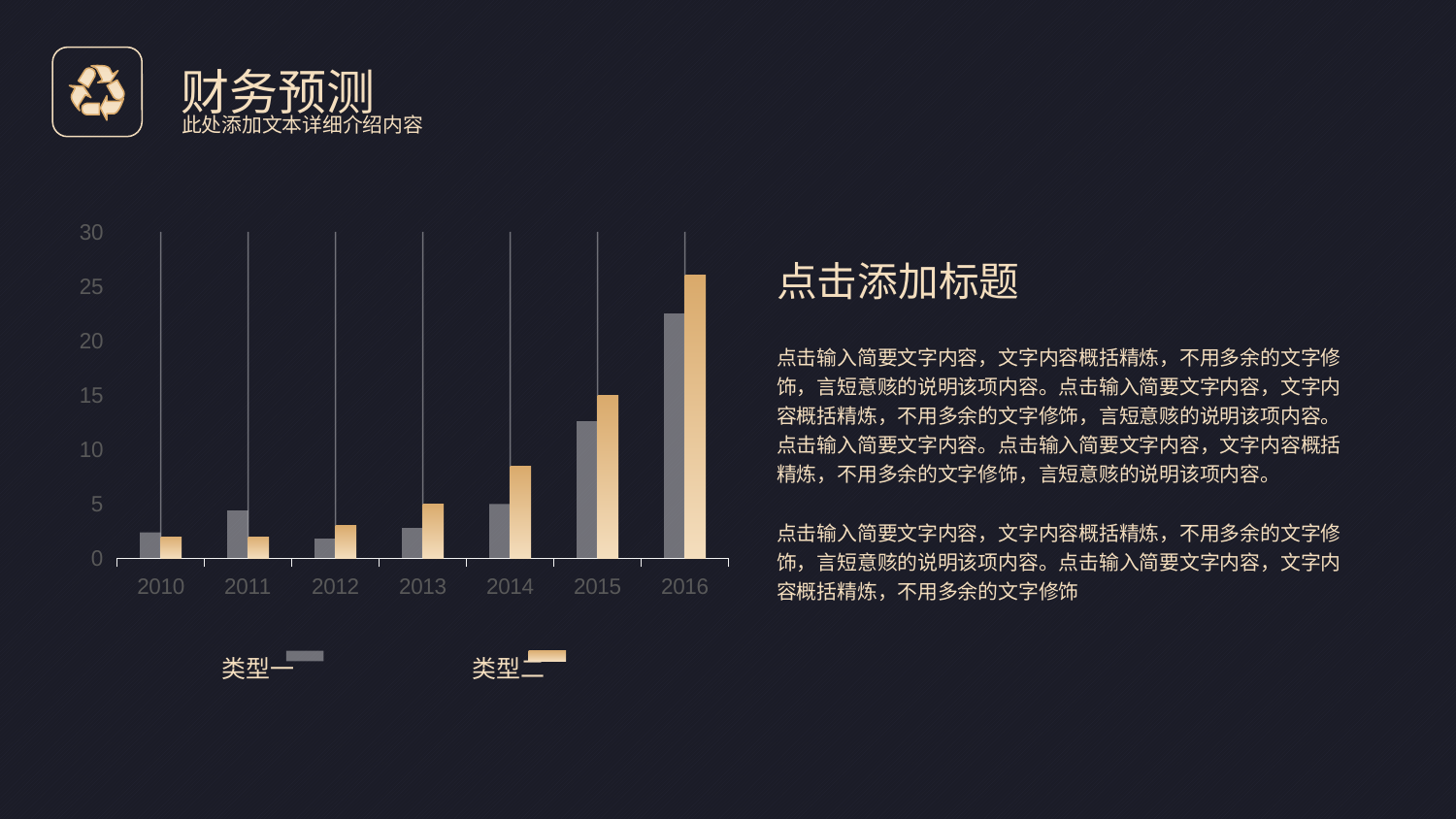
How many series does the chart legend list? 2 Is the value for 类型二 in 2015 greater or less than 10? greater Is the value for 类型二 in 2016 greater or less than 25? greater Do the values for 类型二 generally rise or fall from 2012 to 2016? rise Is the value for 类型一 in 2014 greater or less than 10? less In 2015, which series has the larger value, 类型一 or 类型二? 类型二 How many years are shown on the x axis of the chart? 7 What kind of chart is shown on the slide? bar chart Which year has the highest value for 类型一? 2016 Which colour represents 类型二 in the chart? gold Which year has the highest value for 类型二? 2016